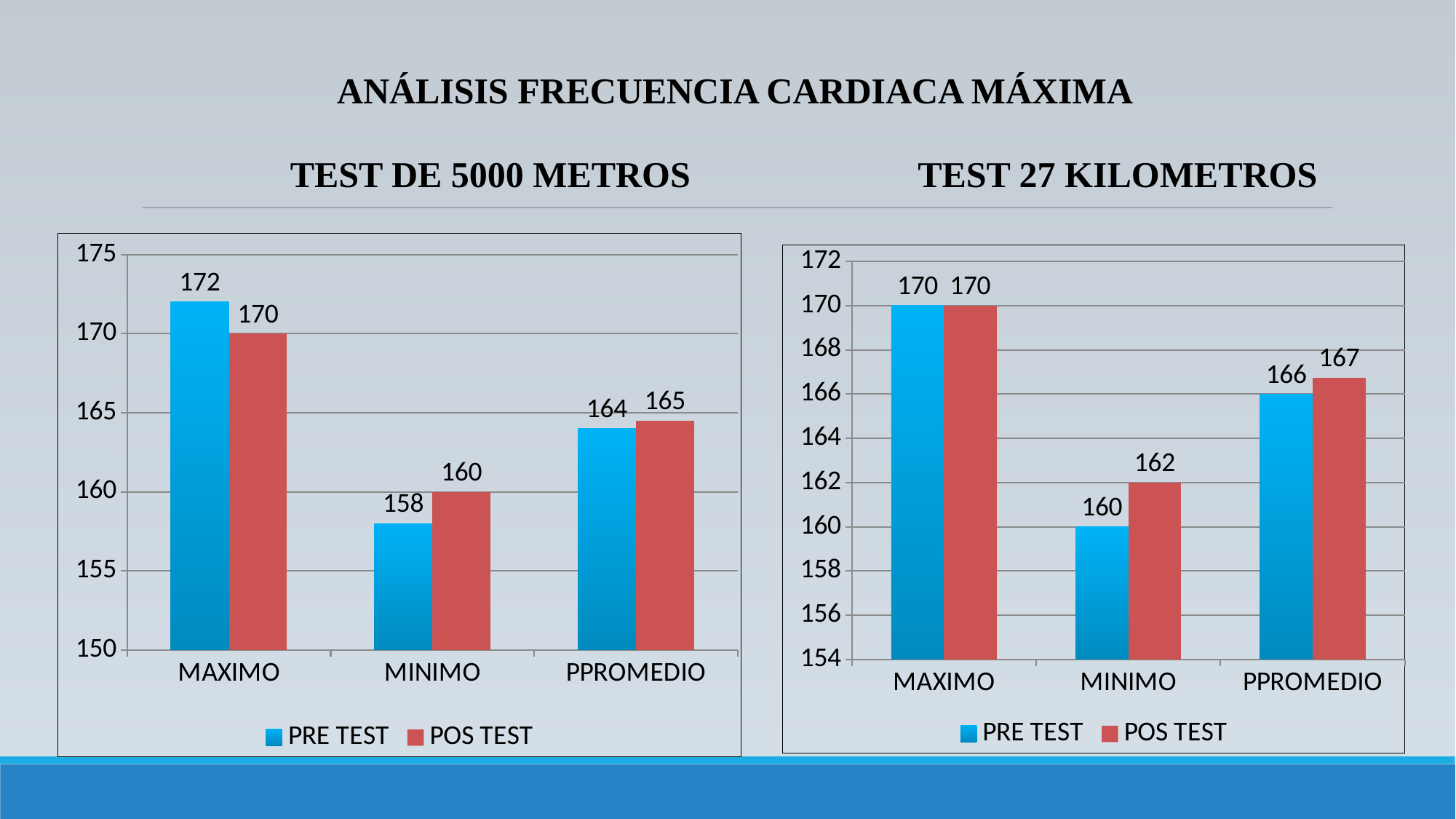
In the TEST DE 5000 METROS chart, which category has the lowest PRE TEST value? MINIMO How many series does the legend of the TEST DE 5000 METROS chart list? 2 In the TEST 27 KILOMETROS chart, what is the PRE TEST value for MINIMO? 160 In the TEST DE 5000 METROS chart, which is larger for PPROMEDIO, the PRE TEST or the POS TEST value? POS TEST In the TEST DE 5000 METROS chart, what is the PRE TEST value for MAXIMO? 172 In the TEST 27 KILOMETROS chart, what is the difference between the POS TEST and PRE TEST values for MINIMO? 2 In the TEST DE 5000 METROS chart, what is the difference between the PRE TEST and POS TEST values for MAXIMO? 2 How many categories are shown on the x axis of the TEST 27 KILOMETROS chart? 3 In the TEST 27 KILOMETROS chart, what is the POS TEST value for PPROMEDIO? 167 In the TEST 27 KILOMETROS chart, which category has the highest POS TEST value? MAXIMO What type of chart is the TEST 27 KILOMETROS chart? Bar chart In the TEST DE 5000 METROS chart, what is the POS TEST value for MINIMO? 160